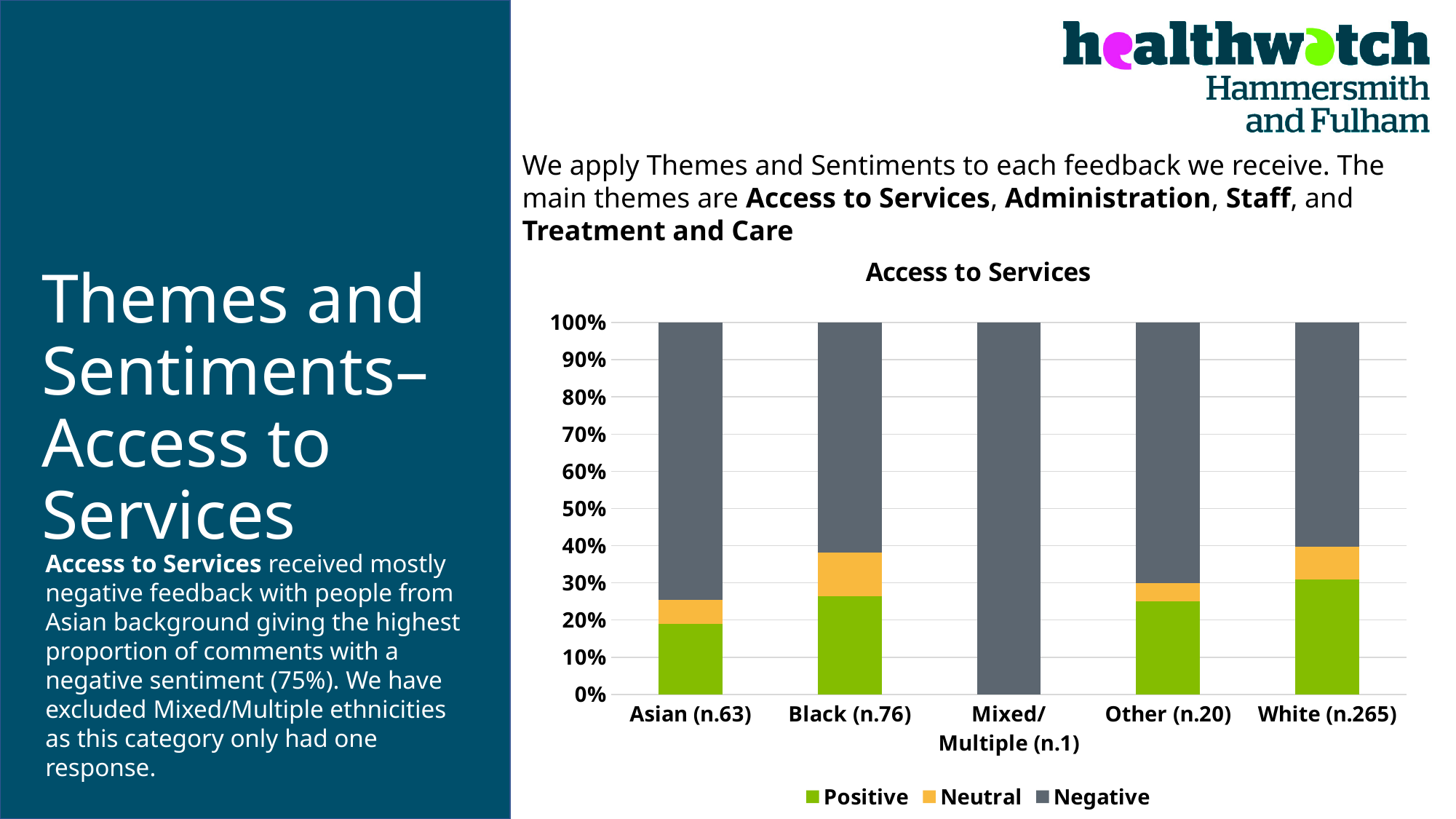
Which category has the lowest share of Positive sentiment in the Access to Services chart? Mixed/Multiple (n.1) Which has the larger Neutral share, Black (n.76) or Asian (n.63)? Black (n.76) How many ethnicity categories are shown on the x axis of the Access to Services chart? 5 How many series does the legend of the Access to Services chart list? 3 Is the Positive share for Black (n.76) greater or less than 20%? greater Which category has the highest share of Negative sentiment in the Access to Services chart? Mixed/Multiple (n.1) Which category has the highest share of Positive sentiment in the Access to Services chart? White (n.265) What kind of chart is shown on the slide? stacked bar chart Is the Negative share for Black (n.76) greater or less than 50%? greater What is the title of the chart? Access to Services Which sentiment is shown in green in the chart? Positive Is the Positive share for Asian (n.63) greater or less than 10%? greater